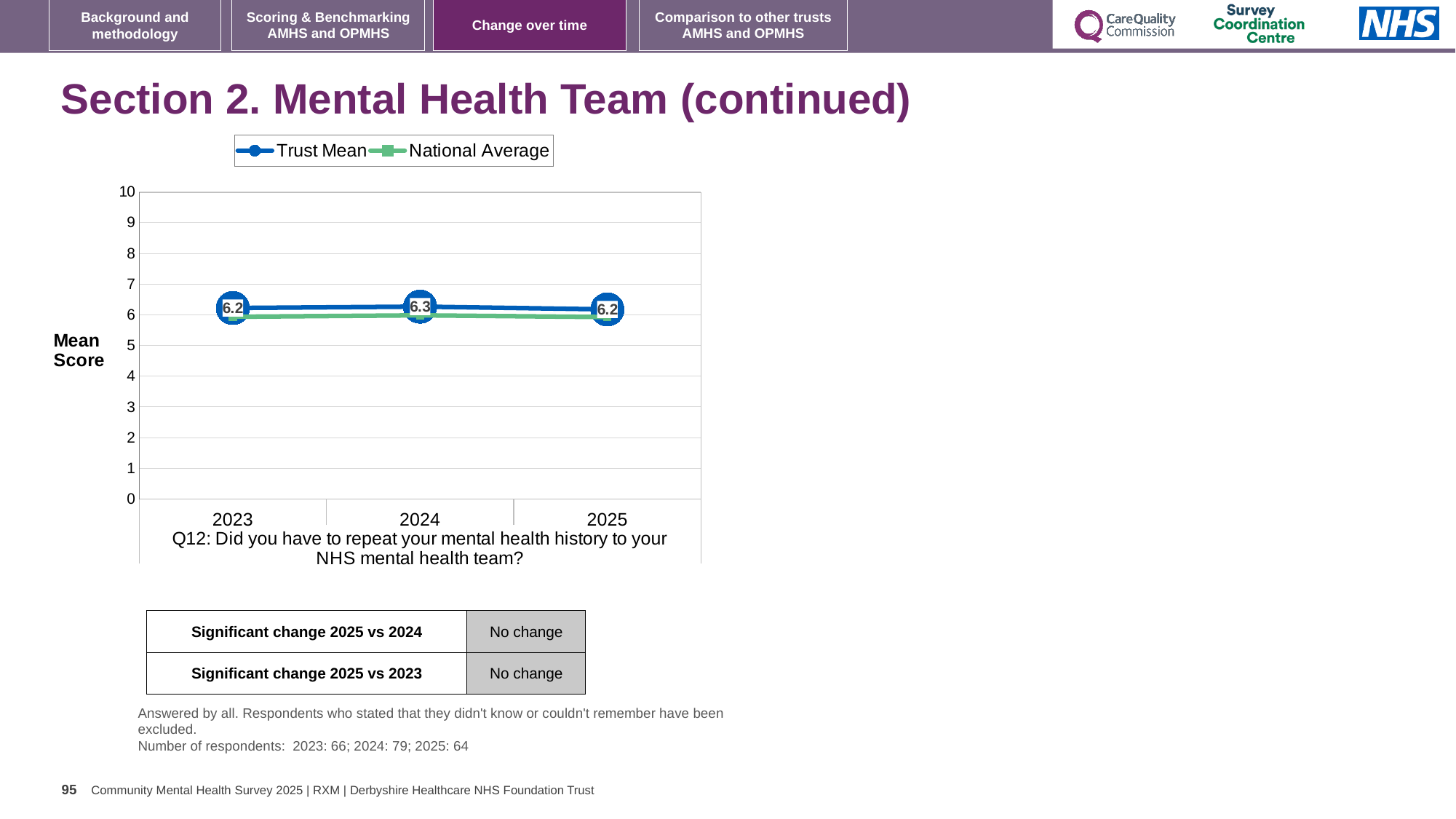
What kind of chart is shown on the slide? line chart Is the National Average for 2023 greater or less than 5? greater Is the National Average for 2025 greater or less than 7? less What is the Trust Mean for 2025? 6.2 Does the Trust Mean rise or fall from 2024 to 2025? fall What is the label on the y axis of the chart? Mean Score How many series does the legend list? 2 What is the Trust Mean for 2023? 6.2 What is the difference between the Trust Mean in 2024 and in 2023? 0.1 How many years are plotted on the x axis? 3 What is the Trust Mean for 2024? 6.3 In which year is the Trust Mean highest? 2024